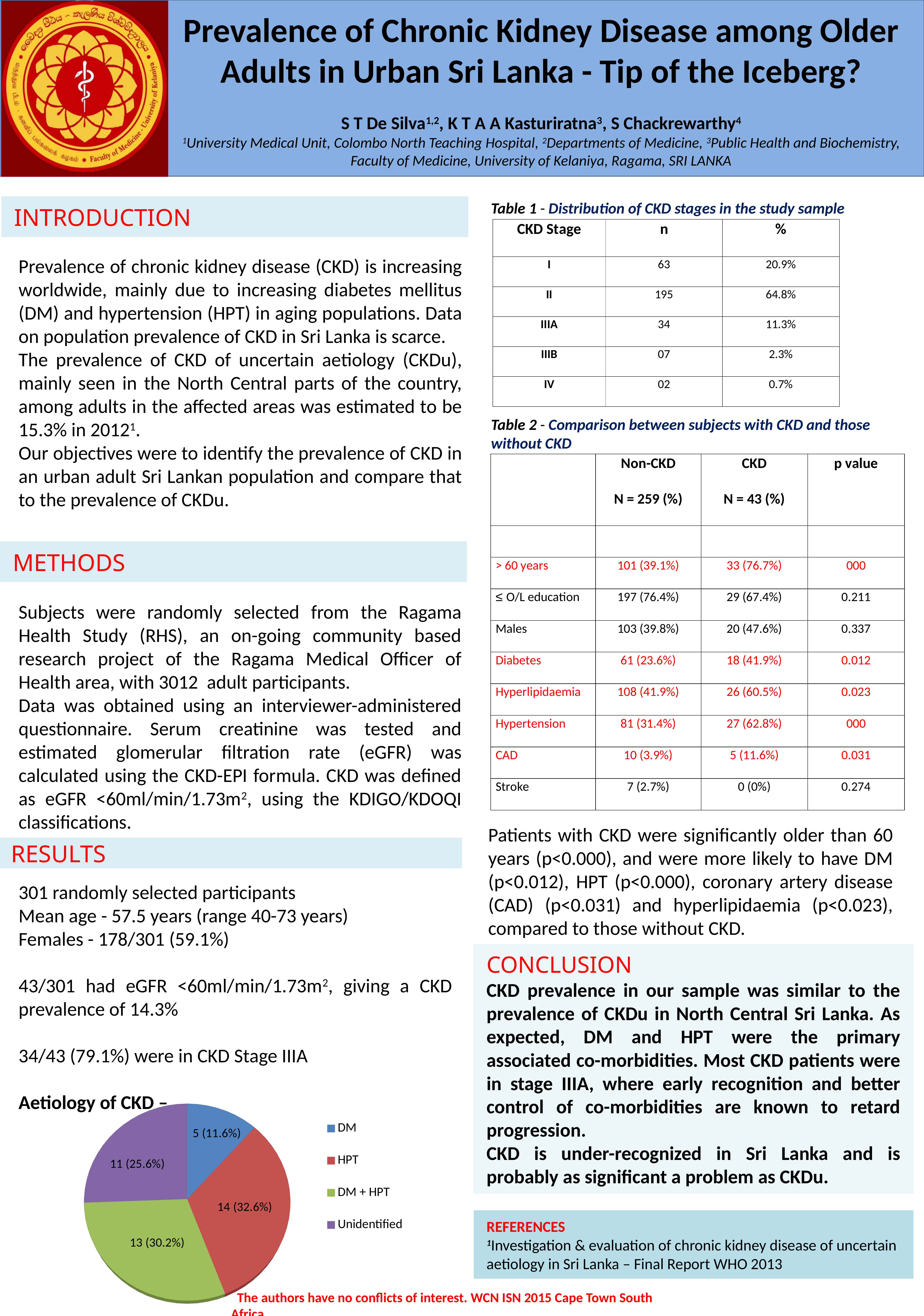
In the aetiology of CKD pie chart, what colour is the HPT slice? red In the aetiology of CKD pie chart, what is the data label for the Unidentified slice? 11 (25.6%) In the aetiology of CKD pie chart, what is the data label for the DM slice? 5 (11.6%) What kind of chart is used to show the aetiology of CKD? pie chart In the aetiology of CKD pie chart, what share of CKD cases is attributed to DM + HPT? 30.2% How many slices does the aetiology of CKD pie chart have? 4 In the aetiology of CKD pie chart, which aetiology has the largest slice? HPT In the aetiology of CKD pie chart, how many more cases are attributed to HPT than to DM? 9 In the aetiology of CKD pie chart, which aetiology has the smallest slice? DM In the aetiology of CKD pie chart, what is the data label for the DM + HPT slice? 13 (30.2%) In the aetiology of CKD pie chart, which is larger: the Unidentified slice or the DM slice? Unidentified In the aetiology of CKD pie chart, what is the data label for the HPT slice? 14 (32.6%)